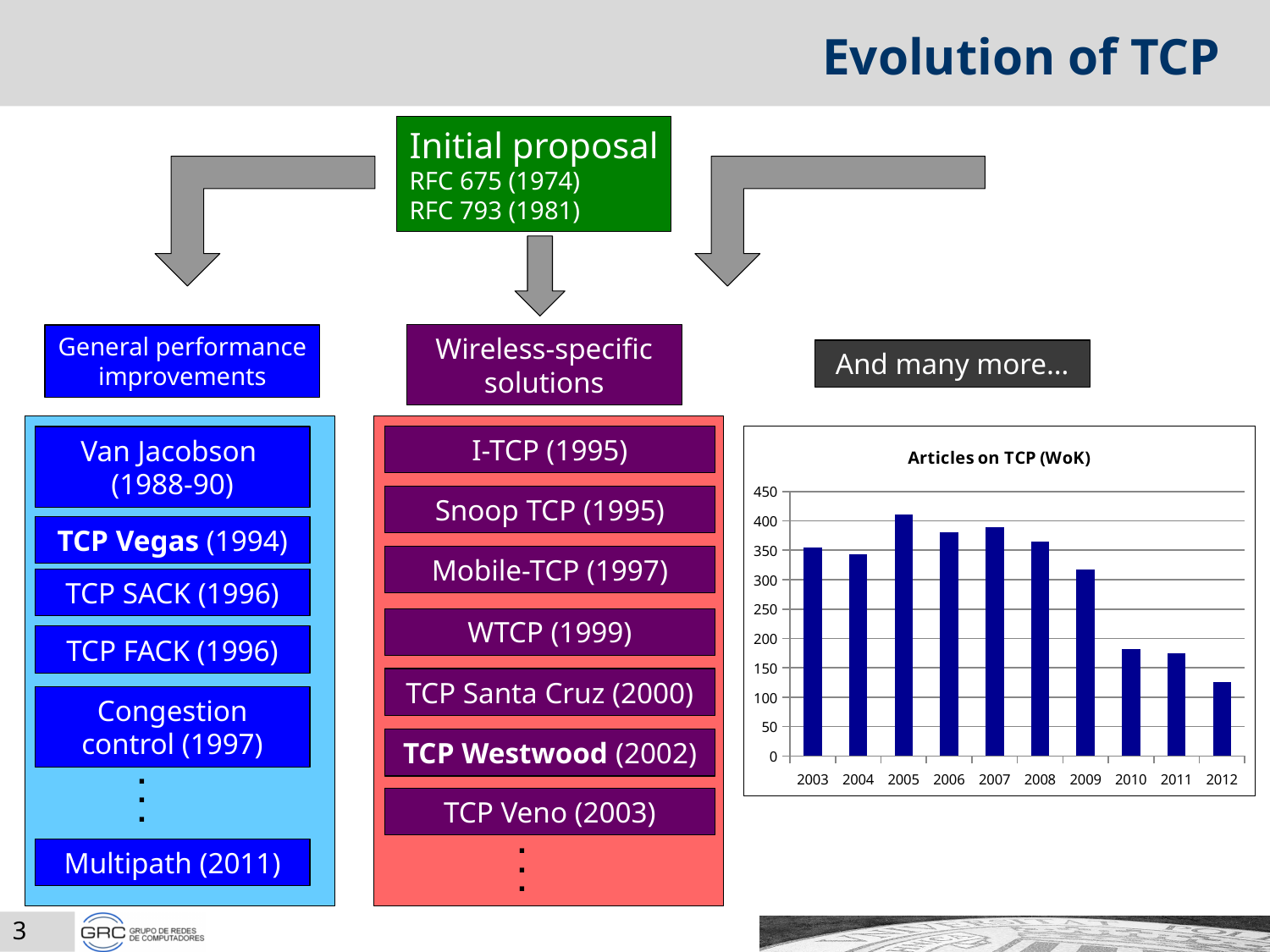
Which year has the highest number of articles on TCP? 2005 What type of chart is shown on the slide? bar chart How many years are shown on the x axis of the chart? 10 Is the value for 2005 greater or less than 400? greater Is the value for 2010 greater or less than 200? less Is the value for 2012 greater or less than 150? less What is the title of the chart on the slide? Articles on TCP (WoK) Do the values in the chart generally rise or fall from 2005 to 2012? fall Which year has the lowest number of articles on TCP? 2012 Which year has more articles on TCP, 2004 or 2006? 2006 Which year has more articles on TCP, 2009 or 2010? 2009